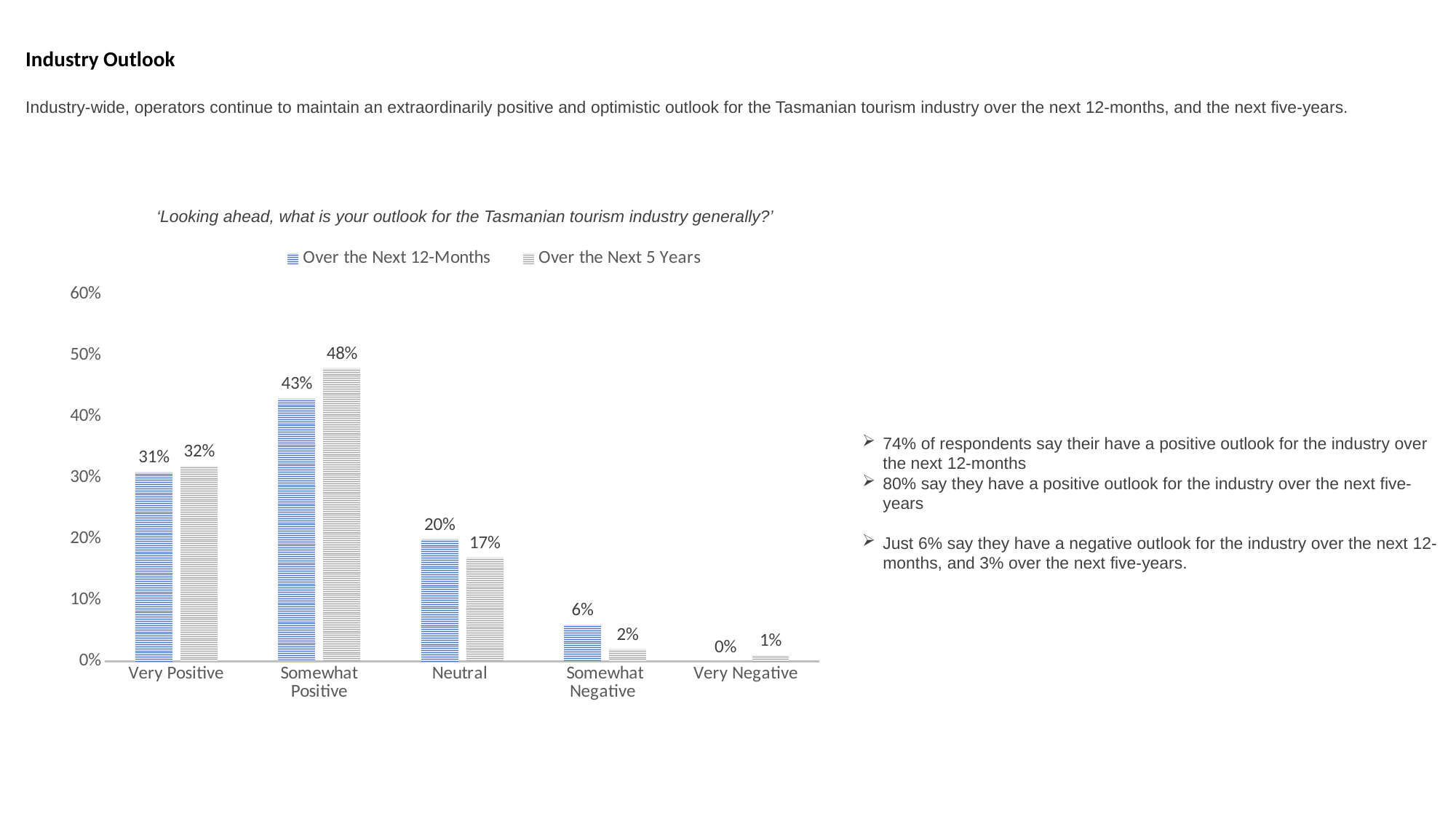
Which category has the highest value in the Over the Next 5 Years series? Somewhat Positive How many series does the legend list? 2 Which category has the lowest value in the Over the Next 12-Months series? Very Negative What is the difference between the Over the Next 5 Years and Over the Next 12-Months values for Somewhat Positive? 5% For Neutral, which series has the larger value: Over the Next 12-Months or Over the Next 5 Years? Over the Next 12-Months What is the difference between the Somewhat Negative values for Over the Next 12-Months and Over the Next 5 Years? 4% What is the value for Very Negative in the Over the Next 12-Months series? 0% What is the value for Neutral in the Over the Next 5 Years series? 17% What kind of chart is shown on the slide? bar chart Is the value for Very Positive in the Over the Next 12-Months series greater or less than 40%? less How many categories are shown on the x axis? 5 What is the value for Somewhat Positive in the Over the Next 12-Months series? 43%